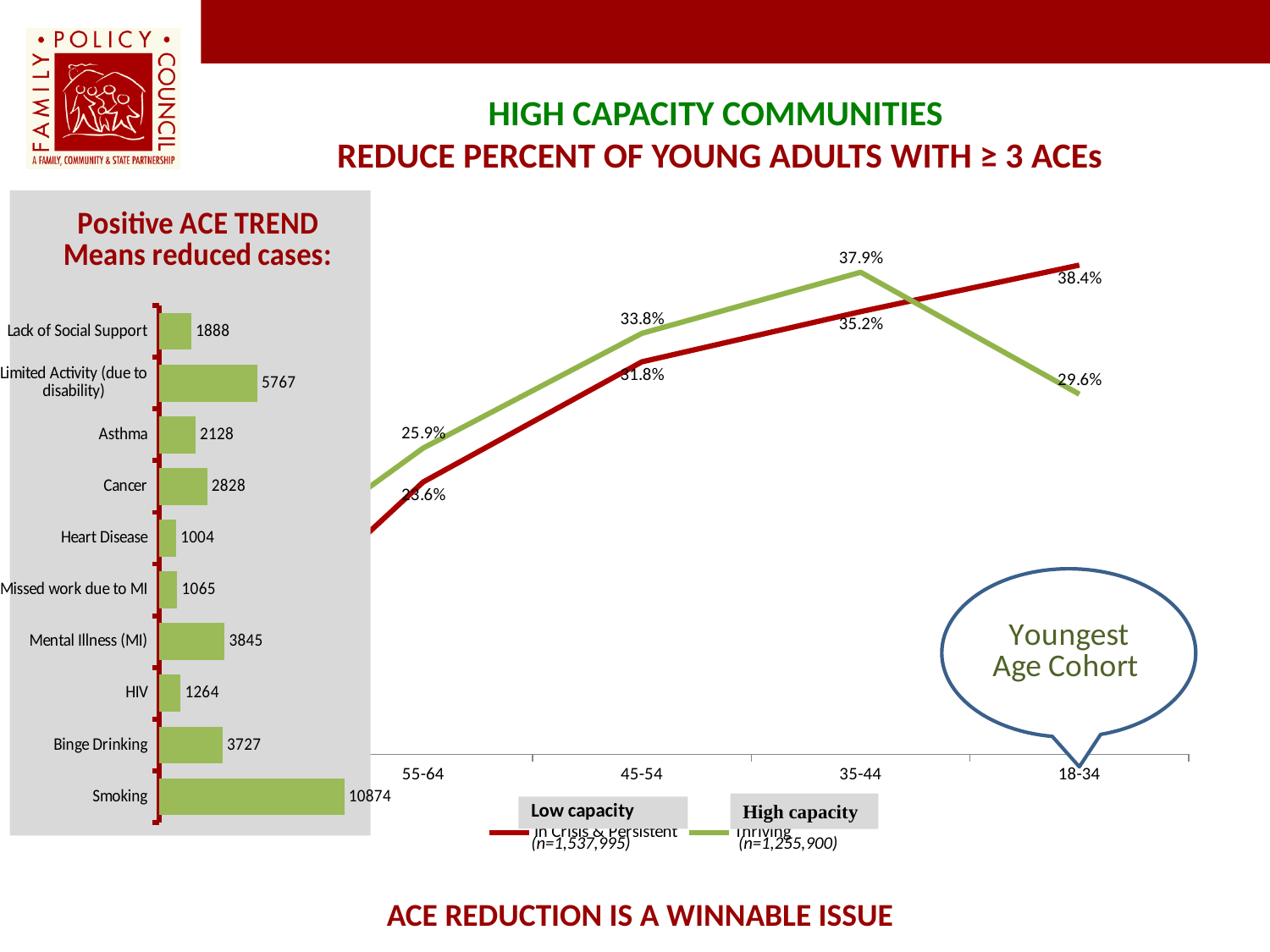
In the bar chart on the left, how many categories are shown? 10 In the bar chart on the left, which category has the highest value? Smoking What kind of chart is the chart on the right? Line chart In the bar chart on the left, what is the value for Smoking? 10874 In the bar chart on the left, which is larger, the value for Cancer or the value for Asthma? Cancer In the line chart on the right, what is the Low capacity value for the 18-34 age group? 38.4% In the bar chart on the left, what is the difference between the values for Mental Illness (MI) and Binge Drinking? 118 In the line chart on the right, how many series does the legend list? 2 In the bar chart on the left, which category has the lowest value? Heart Disease In the bar chart on the left, what is the value for Limited Activity (due to disability)? 5767 In the line chart on the right, what is the difference between the Low capacity and High capacity values for the 18-34 age group? 8.8% In the line chart on the right, what is the High capacity value for the 35-44 age group? 37.9%